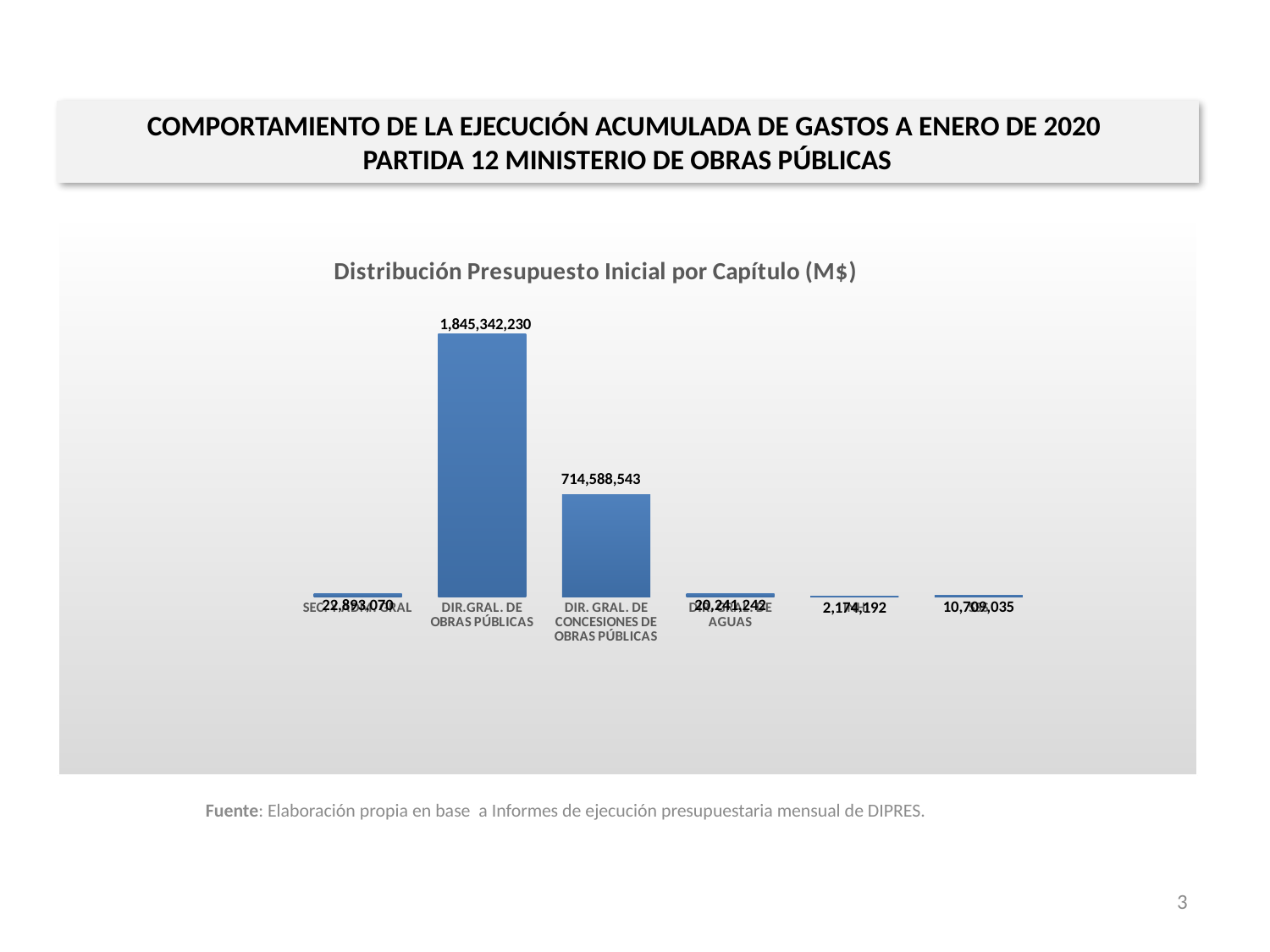
What is the title of the chart? Distribución Presupuesto Inicial por Capítulo (M$) What is the difference between the values for DIR. GRAL. DE CONCESIONES DE OBRAS PÚBLICAS and DIR. GRAL. DE AGUAS? 694,347,301 Which is larger, the value for DIR. GRAL. DE CONCESIONES DE OBRAS PÚBLICAS or the value for DIR. GRAL. DE AGUAS? DIR. GRAL. DE CONCESIONES DE OBRAS PÚBLICAS How many bars are plotted in the chart? 6 Which category has the highest value in the chart? DIR.GRAL. DE OBRAS PÚBLICAS What kind of chart is shown on the slide? Bar chart What is the difference between the values for DIR.GRAL. DE OBRAS PÚBLICAS and DIR. GRAL. DE CONCESIONES DE OBRAS PÚBLICAS? 1,130,753,687 What is the value for DIR. GRAL. DE AGUAS? 20,241,242 What is the value for DIR.GRAL. DE OBRAS PÚBLICAS in the chart? 1,845,342,230 What is the value for DIR. GRAL. DE CONCESIONES DE OBRAS PÚBLICAS? 714,588,543